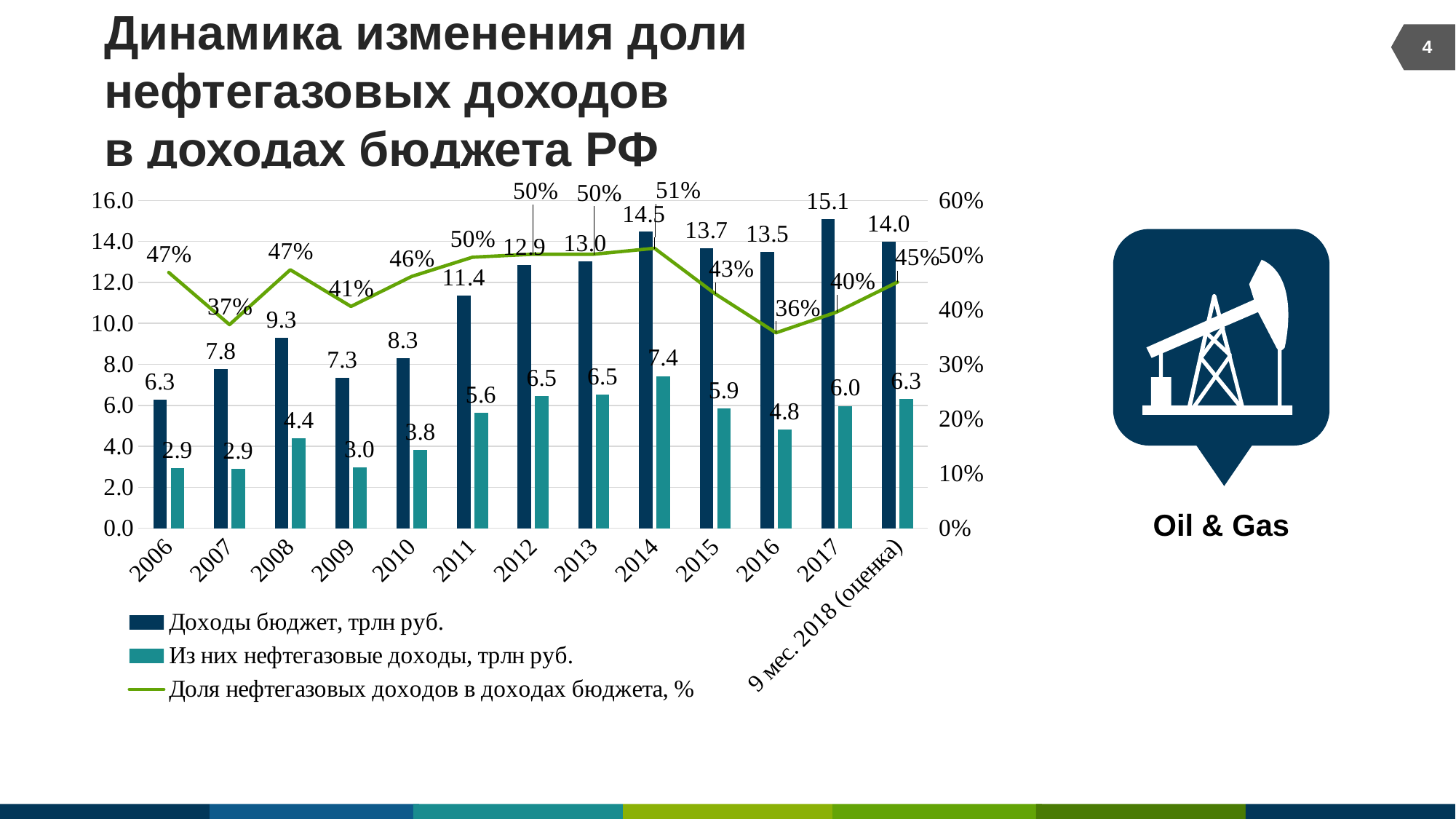
What is the value of "Доля нефтегазовых доходов в доходах бюджета, %" for 2016? 36% What is the label of the last category on the x axis? 9 мес. 2018 (оценка) What kind of chart is shown on the slide? Combined bar and line chart Which is larger: "Из них нефтегазовые доходы, трлн руб." in 2012 or in 2016? 2012 What is the value of "Из них нефтегазовые доходы, трлн руб." for 2014? 7.4 How many categories are shown on the x axis? 13 In which year is "Доля нефтегазовых доходов в доходах бюджета, %" lowest? 2016 How many series does the legend list? 3 Is the value of "Доходы бюджет, трлн руб." for 2011 greater or less than 10.0? greater What is the value of "Доходы бюджет, трлн руб." for 2017? 15.1 What is the difference between "Доходы бюджет, трлн руб." and "Из них нефтегазовые доходы, трлн руб." in 2014? 7.1 In which year is "Доходы бюджет, трлн руб." highest? 2017